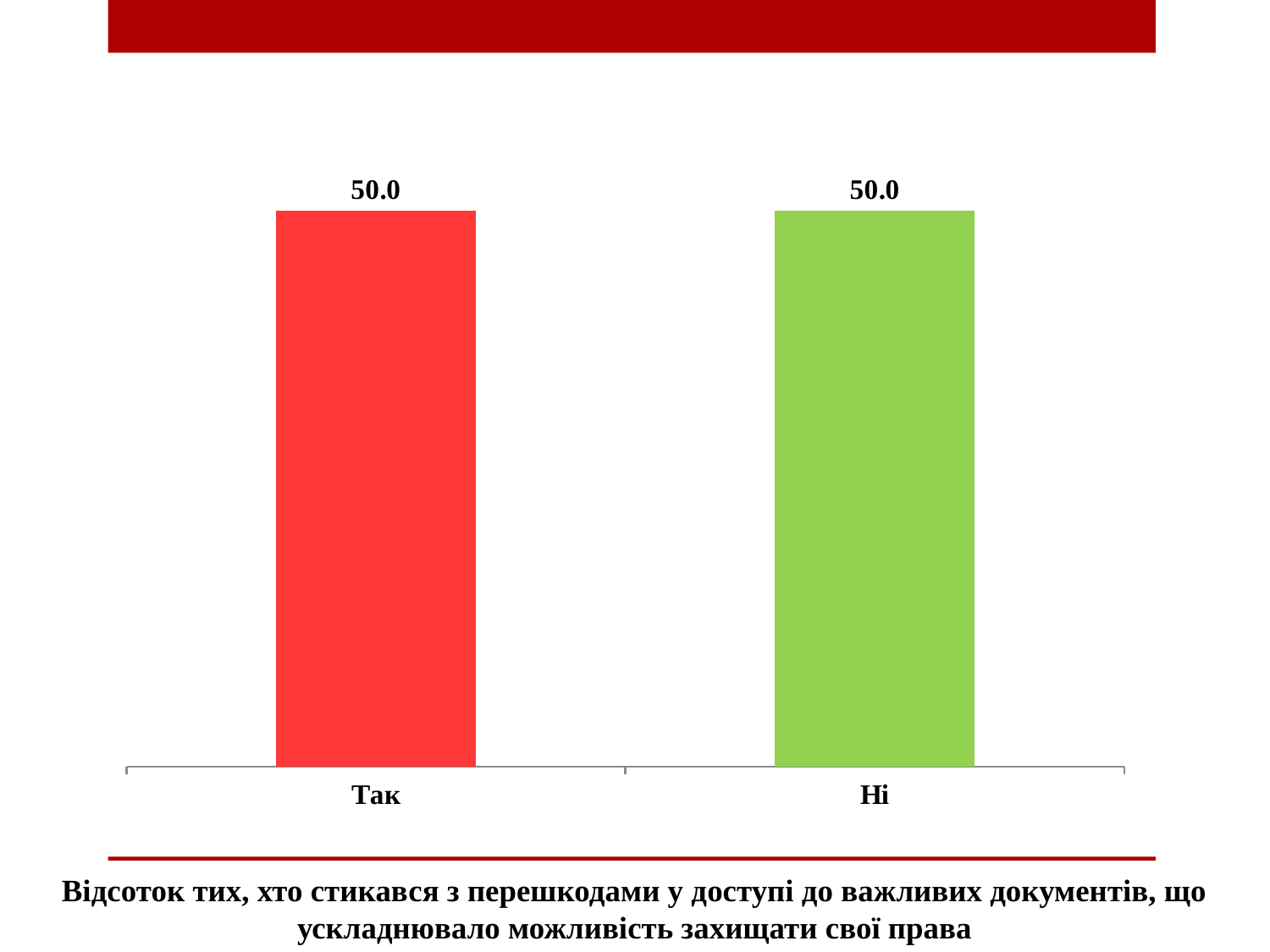
What colour is the bar for "Так"? red What is the value for "Ні"? 50.0 What is the total of the values for "Так" and "Ні"? 100.0 What is the difference between the values for "Так" and "Ні"? 0.0 Are the values for "Так" and "Ні" equal? yes What kind of chart is shown on the slide? bar chart How many categories are shown on the x axis? 2 What is the value for "Так"? 50.0 What colour is the bar for "Ні"? green